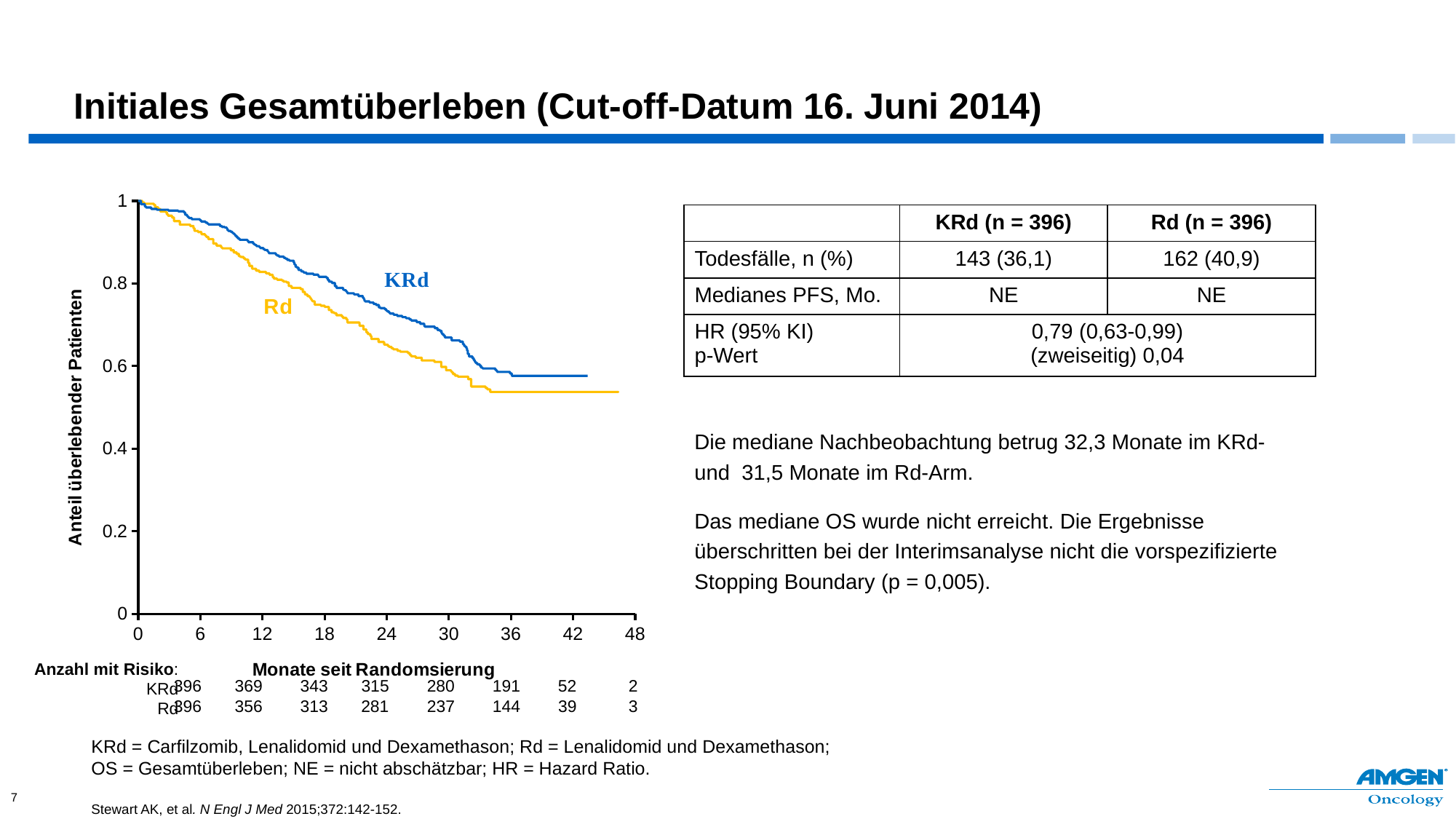
Is the KRd curve at 24 months greater or less than 0.6? greater What kind of chart is shown on the slide? Line chart (Kaplan-Meier survival curve) Is the Rd curve at 18 months greater or less than 0.8? less Is the Rd curve at 36 months greater or less than 0.6? less According to the number-at-risk table under the chart, how many Rd patients were at risk at 30 months? 144 Do the survival curves rise or fall as months since randomisation increase? Fall What is the label of the y-axis of the chart? Anteil überlebender Patienten What colour is the Rd curve in the chart? Yellow How many series (treatment arms) are plotted in the chart? 2 Which curve lies higher over most of the follow-up period, KRd or Rd? KRd According to the number-at-risk table under the chart, how many KRd patients were at risk at 24 months? 280